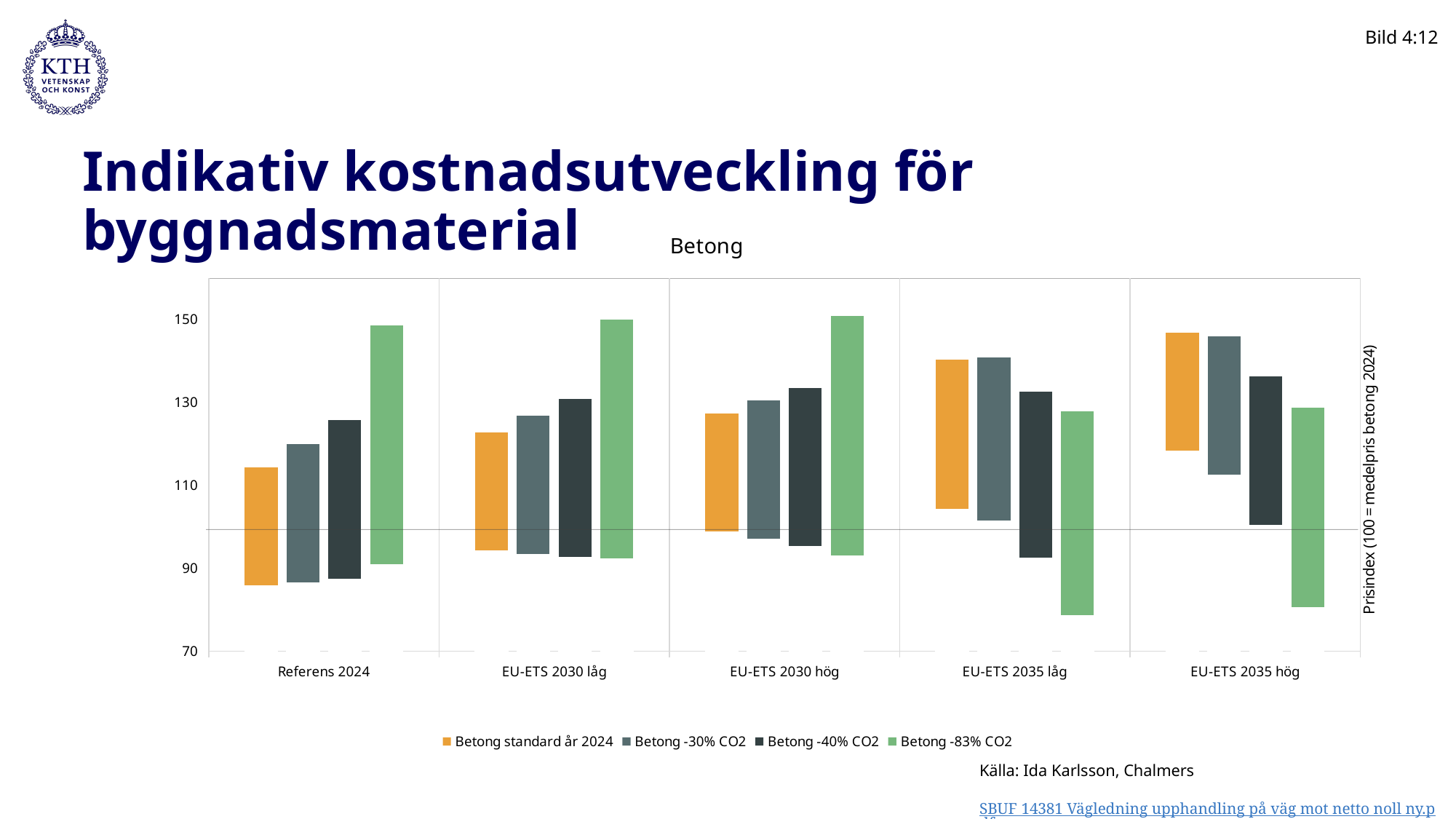
How many series does the chart legend list? 4 What kind of chart is shown on the slide? bar chart Is the top of the Betong standard år 2024 bar for EU-ETS 2035 hög greater or less than 130? greater What is the label of the vertical axis of the chart? Prisindex (100 = medelpris betong 2024) Is the top of the Betong -83% CO2 bar for Referens 2024 greater or less than 130? greater How many categories are shown along the x axis of the chart? 5 Is the bottom of the Betong standard år 2024 bar for Referens 2024 greater or less than 90? less For Referens 2024, which series reaches the highest value on the chart? Betong -83% CO2 For EU-ETS 2035 hög, which series reaches the lowest value on the chart? Betong -83% CO2 What is the title of the chart? Betong